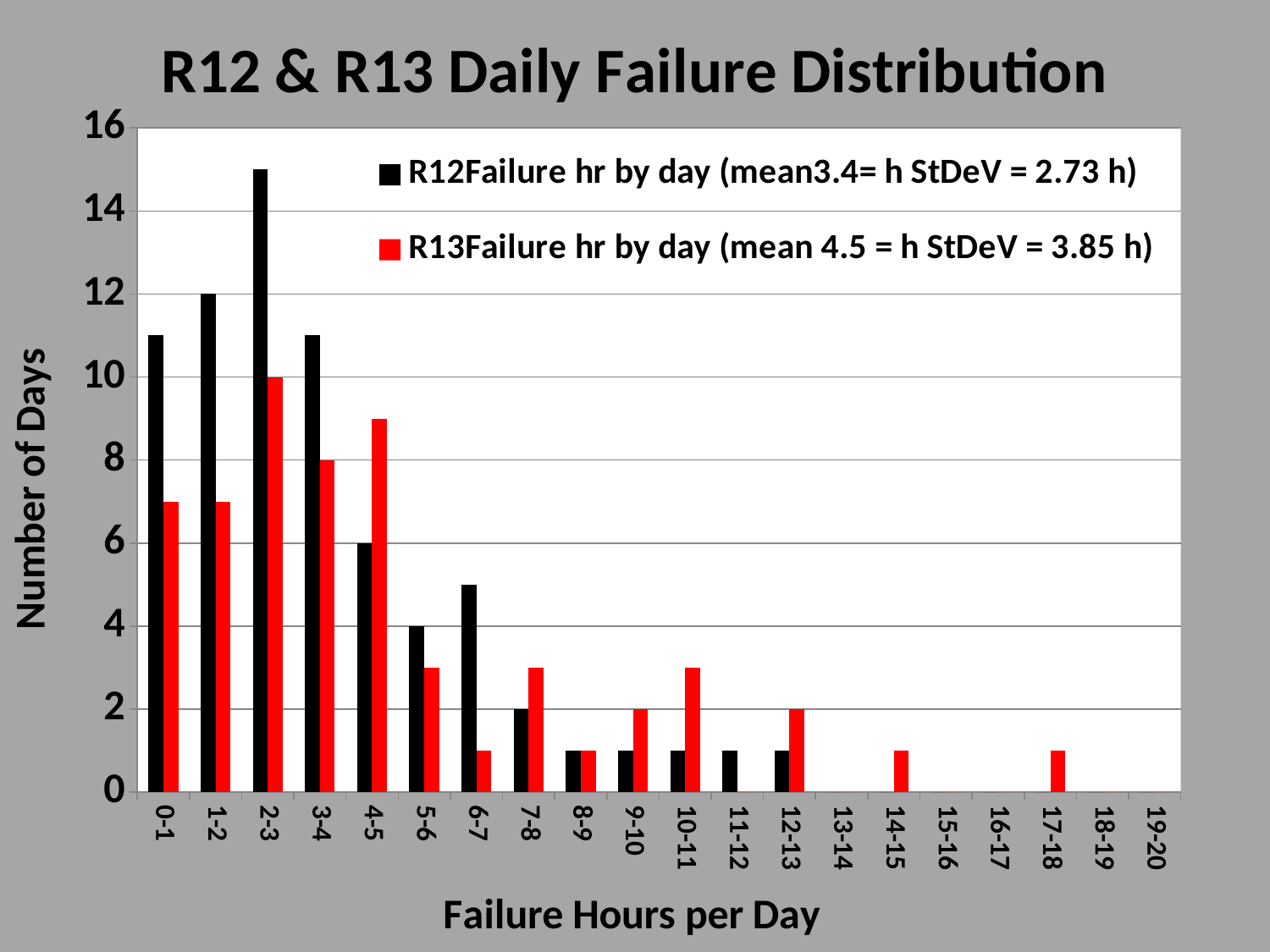
Which failure hours category has the highest number of days for R13? 2-3 In the 4-5 failure hours category, which series has more days, R12 or R13? R13 What is the number of days for R12 in the 1-2 failure hours category? 12 How many failure-hour categories are shown on the x axis? 20 Is the R12 value for the 2-3 category greater or less than 14? greater What is the number of days for R13 in the 3-4 failure hours category? 8 What is the number of days for R13 in the 2-3 failure hours category? 10 Which failure hours category has the highest number of days for R12? 2-3 How many series does the legend list? 2 What kind of chart is shown on the slide? bar chart What is the number of days for R12 in the 4-5 failure hours category? 6 What is the difference between the R12 values for the 4-5 and 5-6 categories? 2